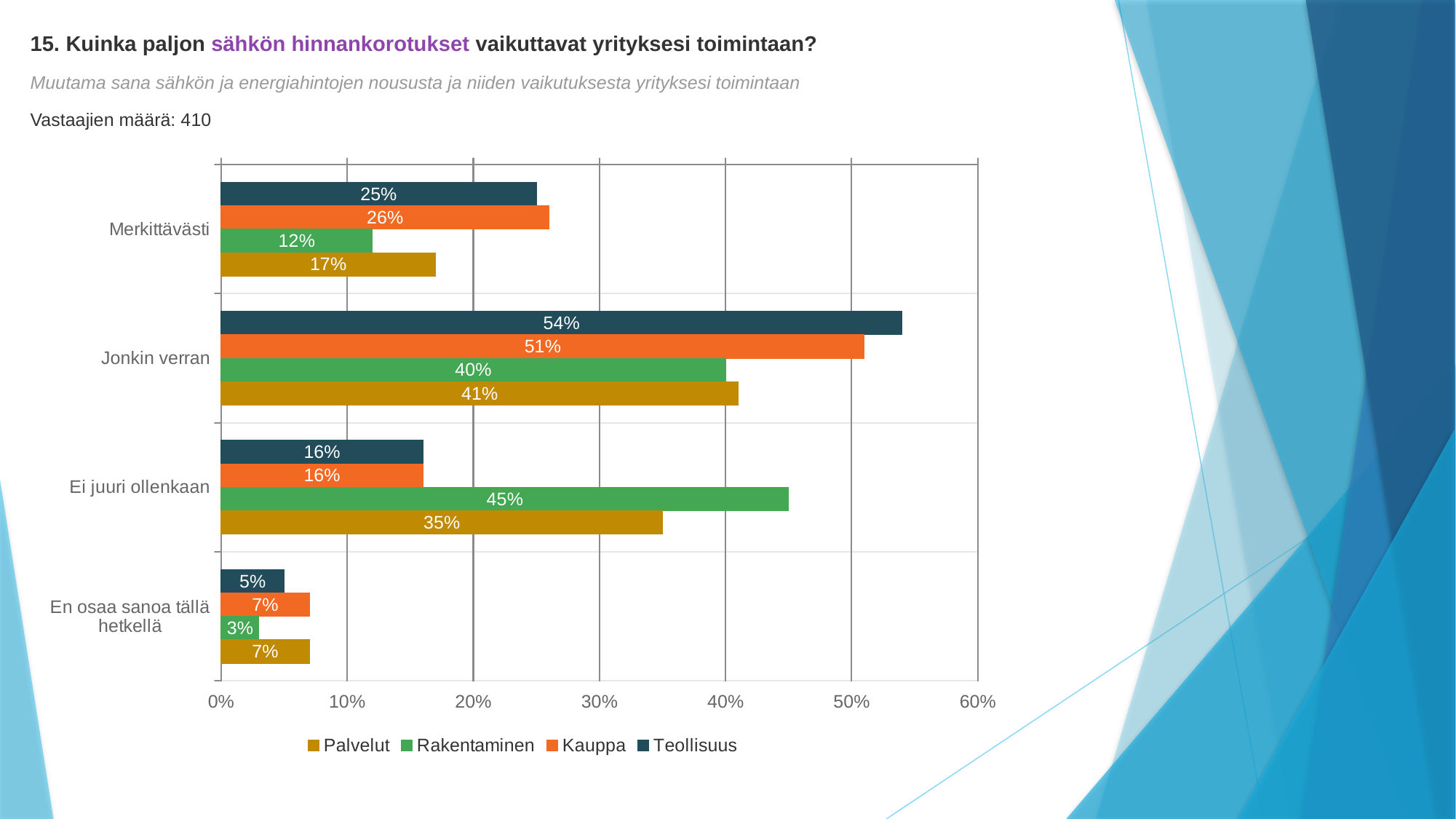
What is the value for Kauppa in the En osaa sanoa tällä hetkellä category? 7% Which series has the highest value in the Merkittävästi category? Kauppa What is the difference between the Rakentaminen and Palvelut values in the Ei juuri ollenkaan category? 10% What is the value for Palvelut in the Merkittävästi category? 17% How many series does the legend list? 4 What is the maximum value shown on the x axis? 60% What is the value for Teollisuus in the Jonkin verran category? 54% What kind of chart is shown on the slide? Bar chart How many categories are shown on the chart? 4 What is the value for Rakentaminen in the Ei juuri ollenkaan category? 45% Which is larger in the Jonkin verran category: Teollisuus or Rakentaminen? Teollisuus Which series has the lowest value in the En osaa sanoa tällä hetkellä category? Rakentaminen